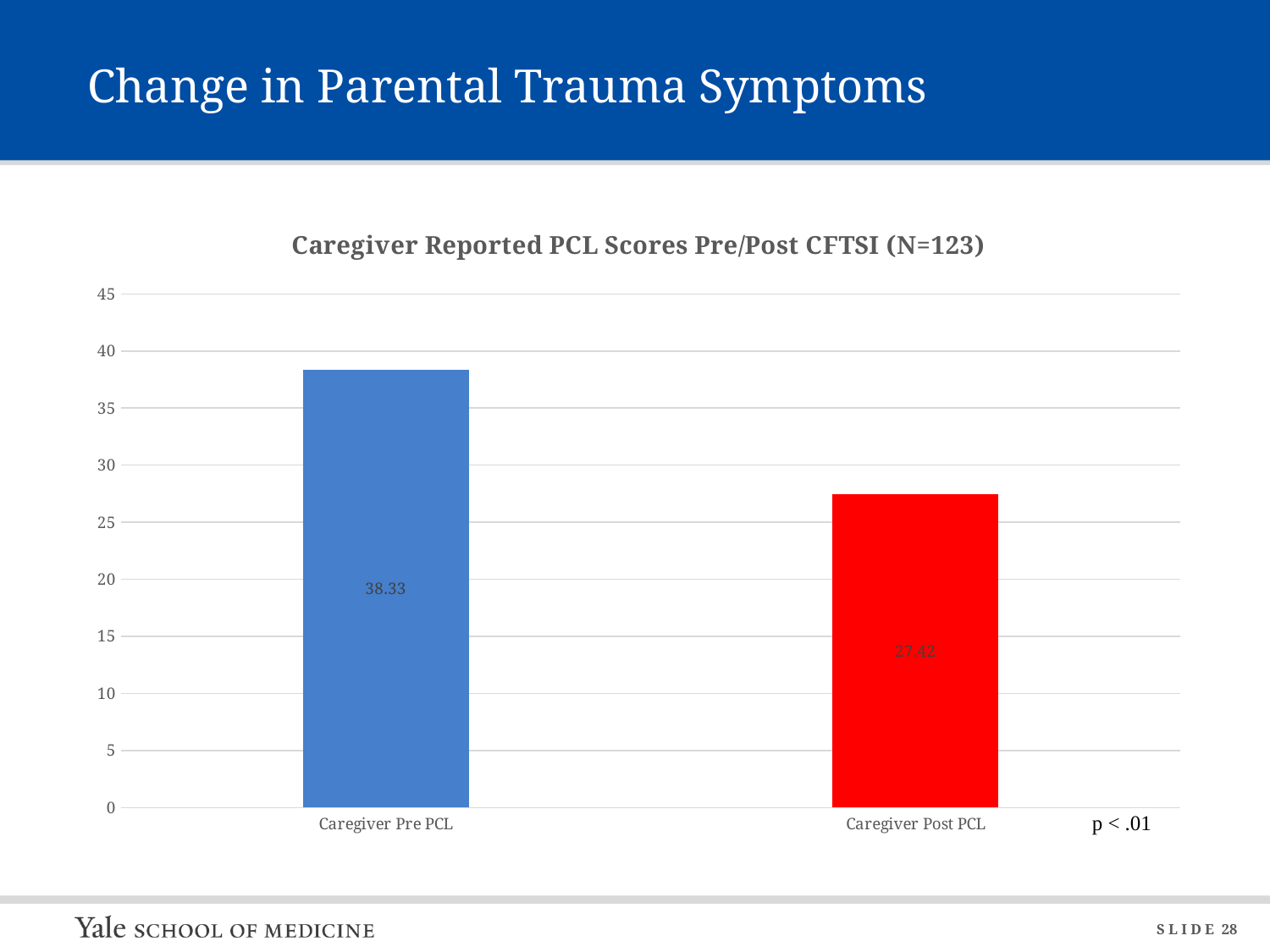
Which category has the lowest value? Caregiver Post PCL What is the value for Caregiver Post PCL? 27.42 Which is larger, the value for Caregiver Pre PCL or Caregiver Post PCL? Caregiver Pre PCL What kind of chart is shown on the slide? Bar chart Do the values rise or fall from Caregiver Pre PCL to Caregiver Post PCL? Fall What is the difference between the Caregiver Pre PCL and Caregiver Post PCL values? 10.91 What is the title of the chart? Caregiver Reported PCL Scores Pre/Post CFTSI (N=123) How many categories are shown on the chart? 2 What is the value for Caregiver Pre PCL? 38.33 Which category has the highest value? Caregiver Pre PCL Is the value for Caregiver Post PCL greater or less than 30? less Is the value for Caregiver Pre PCL greater or less than 35? greater